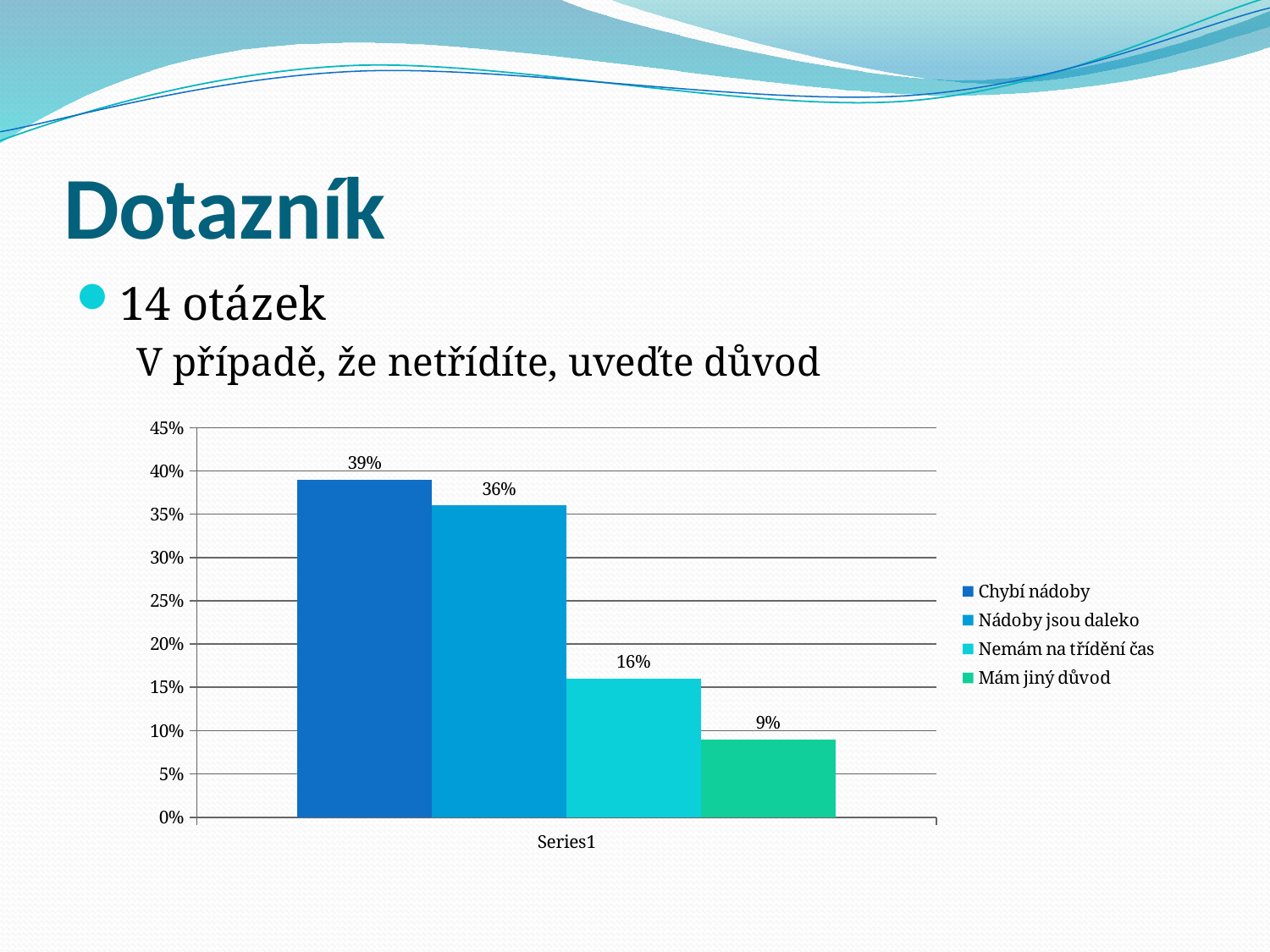
What is the difference between the values for Nemám na třídění čas and Mám jiný důvod? 7% What is the value for Nádoby jsou daleko? 36% What kind of chart is shown on the slide? Bar chart What is the value for Chybí nádoby? 39% What is the difference between the values for Chybí nádoby and Nádoby jsou daleko? 3% Which reason has the lowest value? Mám jiný důvod Which is larger, the value for Nádoby jsou daleko or the value for Nemám na třídění čas? Nádoby jsou daleko What is the value for Nemám na třídění čas? 16% What is the value for Mám jiný důvod? 9% What is the label shown on the x axis below the bars? Series1 How many entries does the legend list? 4 Which reason has the highest value? Chybí nádoby